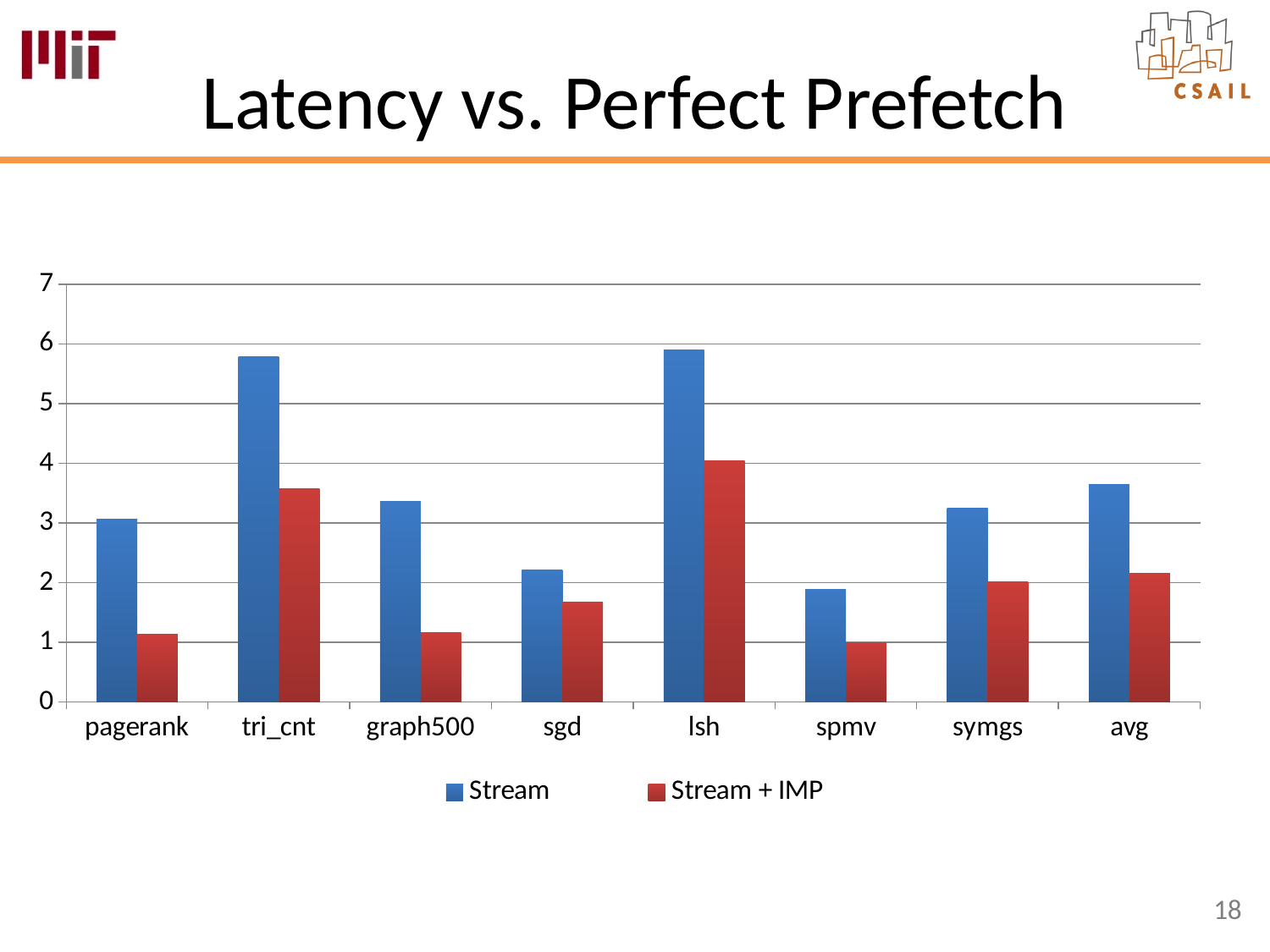
Is the Stream value for tri_cnt greater or less than 5? greater What is the title of the slide containing the chart? Latency vs. Perfect Prefetch Which is larger for graph500, the Stream value or the Stream + IMP value? Stream Which category has the lowest Stream value? spmv How many series does the legend list? 2 Which category has the highest Stream + IMP value? lsh Which is larger, the Stream + IMP value for tri_cnt or the Stream + IMP value for symgs? tri_cnt What kind of chart is shown on the slide? bar chart Is the Stream value for sgd greater or less than 2? greater How many categories are shown on the x axis? 8